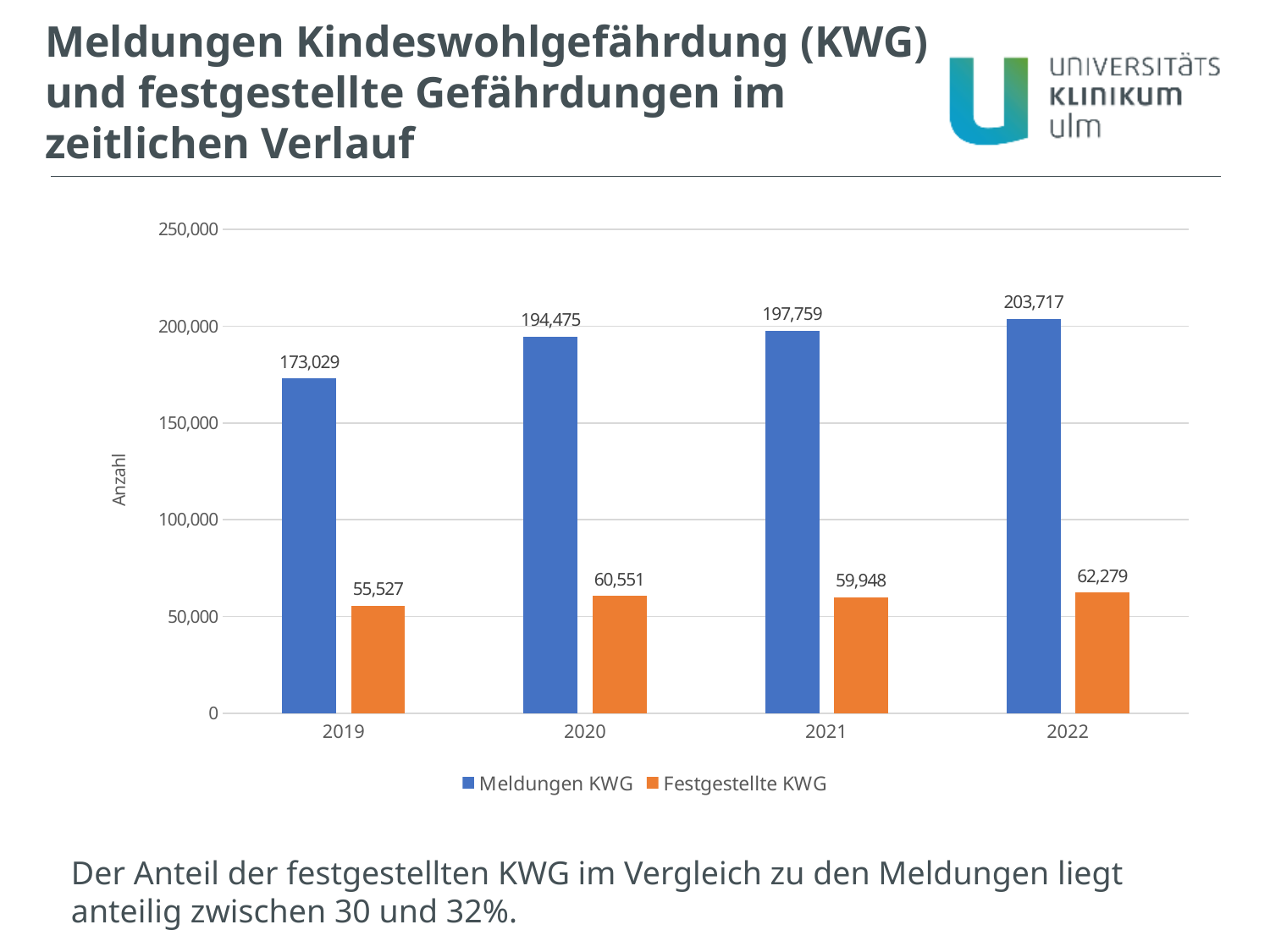
What kind of chart is shown on the slide? Bar chart Is the value for Meldungen KWG in 2021 greater or less than 150,000? greater Which year has the highest value for Meldungen KWG? 2022 What is the difference between Meldungen KWG and Festgestellte KWG in 2020? 133,924 What is the value of Meldungen KWG for 2022? 203,717 What is the value of Festgestellte KWG for 2021? 59,948 Do the values for Meldungen KWG rise or fall from 2019 to 2022? Rise How many series does the legend list? 2 What is the value of Meldungen KWG for 2019? 173,029 Which year has the lowest value for Festgestellte KWG? 2019 Which is larger: Festgestellte KWG in 2020 or Festgestellte KWG in 2021? Festgestellte KWG in 2020 How many years are shown on the x axis? 4